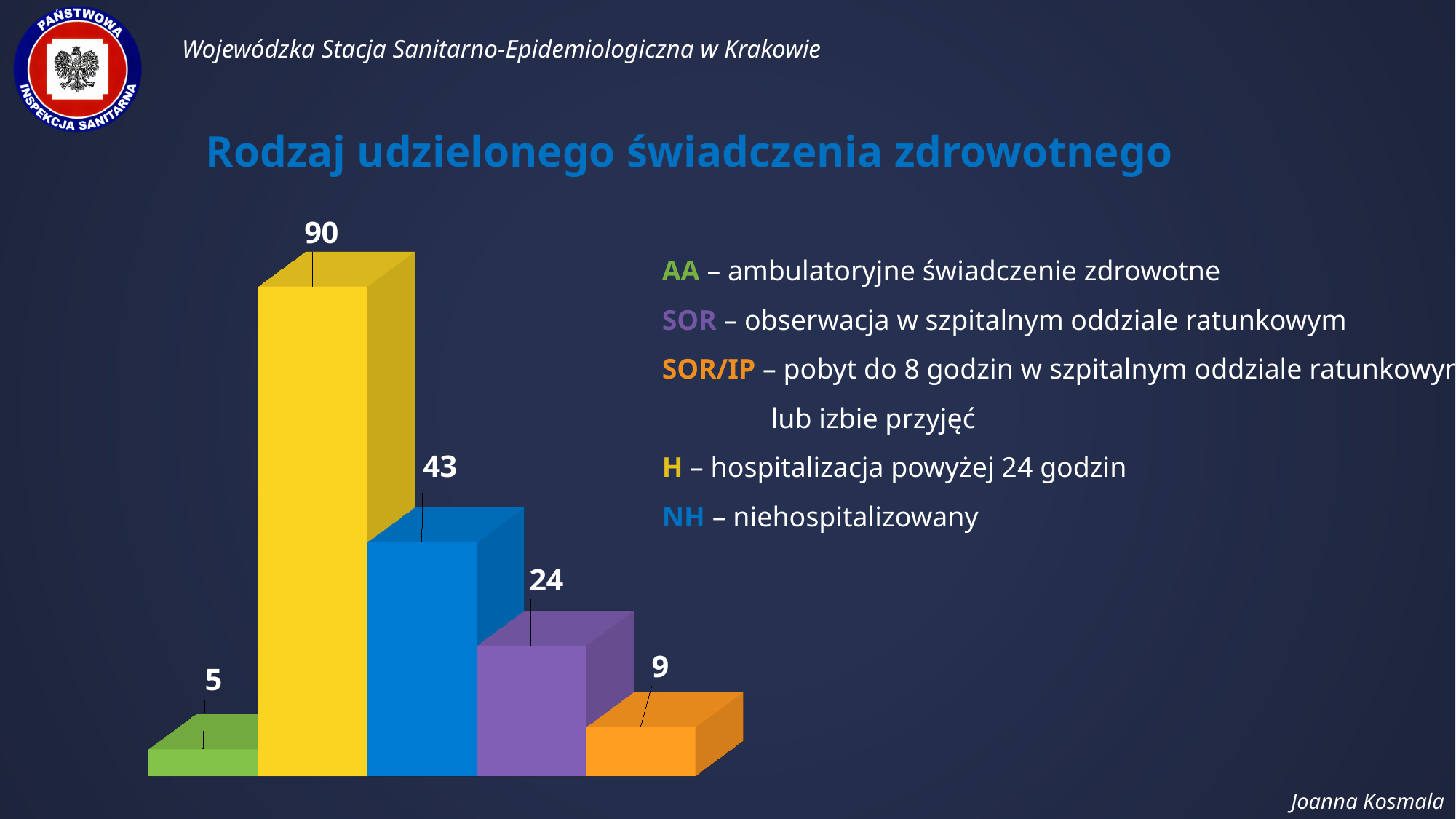
What is the value of the purple bar (SOR)? 24 What is the value of the yellow bar (H – hospitalizacja powyżej 24 godzin)? 90 What is the difference between the value for H (90) and the value for NH (43)? 47 How many bars are plotted in the chart? 5 What is the title of the chart on the slide? Rodzaj udzielonego świadczenia zdrowotnego Which is larger, the value for SOR or the value for SOR/IP? SOR What type of chart is shown on the slide? bar chart What is the value of the blue bar (NH – niehospitalizowany)? 43 What is the value of the green bar (AA – ambulatoryjne świadczenie zdrowotne)? 5 Which category has the lowest value in the chart? AA – ambulatoryjne świadczenie zdrowotne What is the value of the orange bar (SOR/IP)? 9 Which category has the highest value in the chart? H – hospitalizacja powyżej 24 godzin